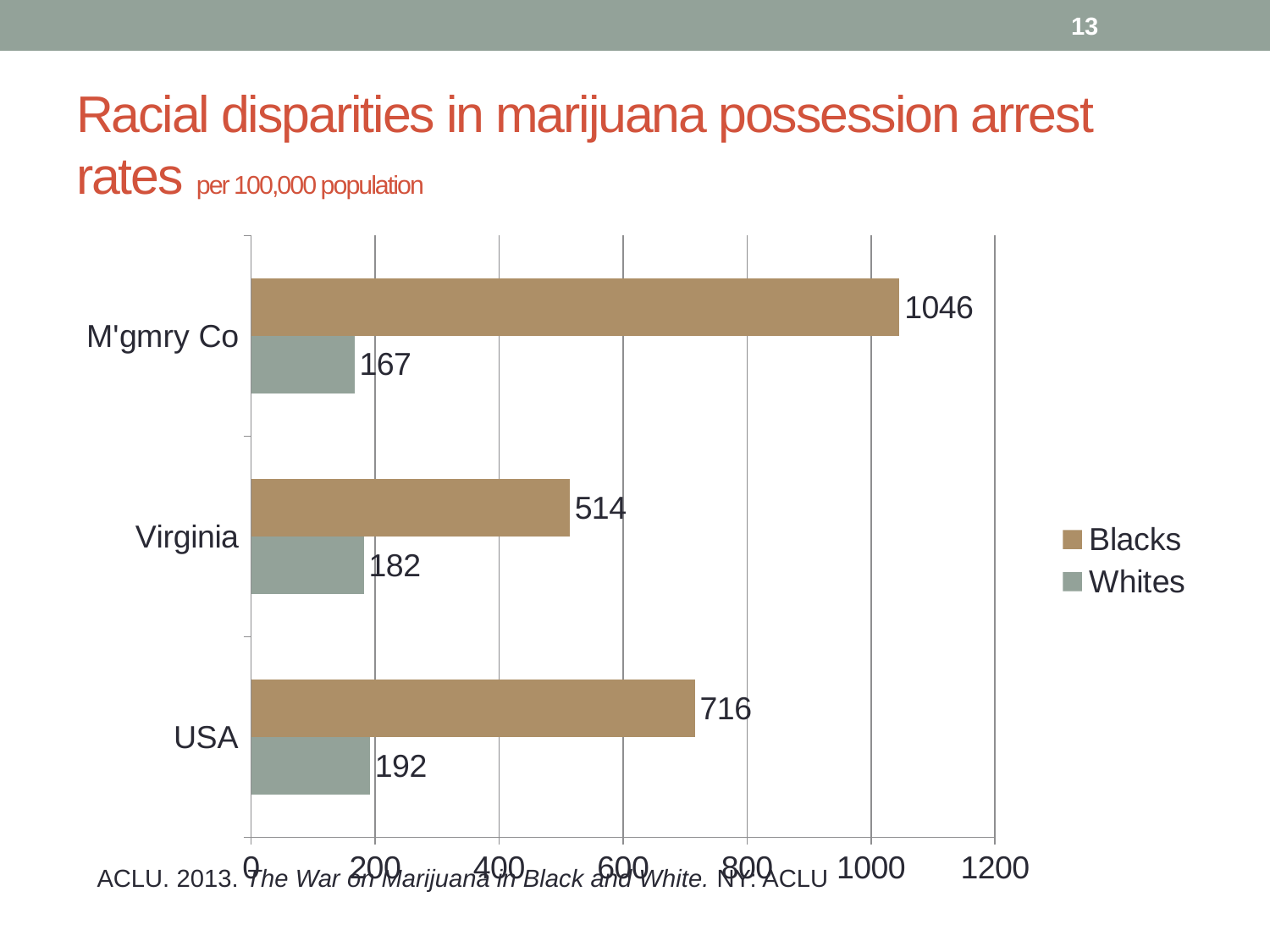
Which category has the highest arrest rate for Blacks? M'gmry Co What is the arrest rate for Blacks in the USA? 716 Which category has the lowest arrest rate for Whites? M'gmry Co What is the difference between the Blacks and Whites arrest rates in M'gmry Co? 879 What is the difference between the Blacks arrest rate in the USA and in Virginia? 202 How many categories are shown on the chart? 3 What is the arrest rate for Whites in Virginia? 182 What kind of chart is shown on the slide? bar chart How many series does the legend list? 2 Is the Blacks arrest rate in M'gmry Co greater or less than 1000? greater Which is larger, the Blacks arrest rate in Virginia or in the USA? USA What is the marijuana possession arrest rate for Blacks in M'gmry Co? 1046